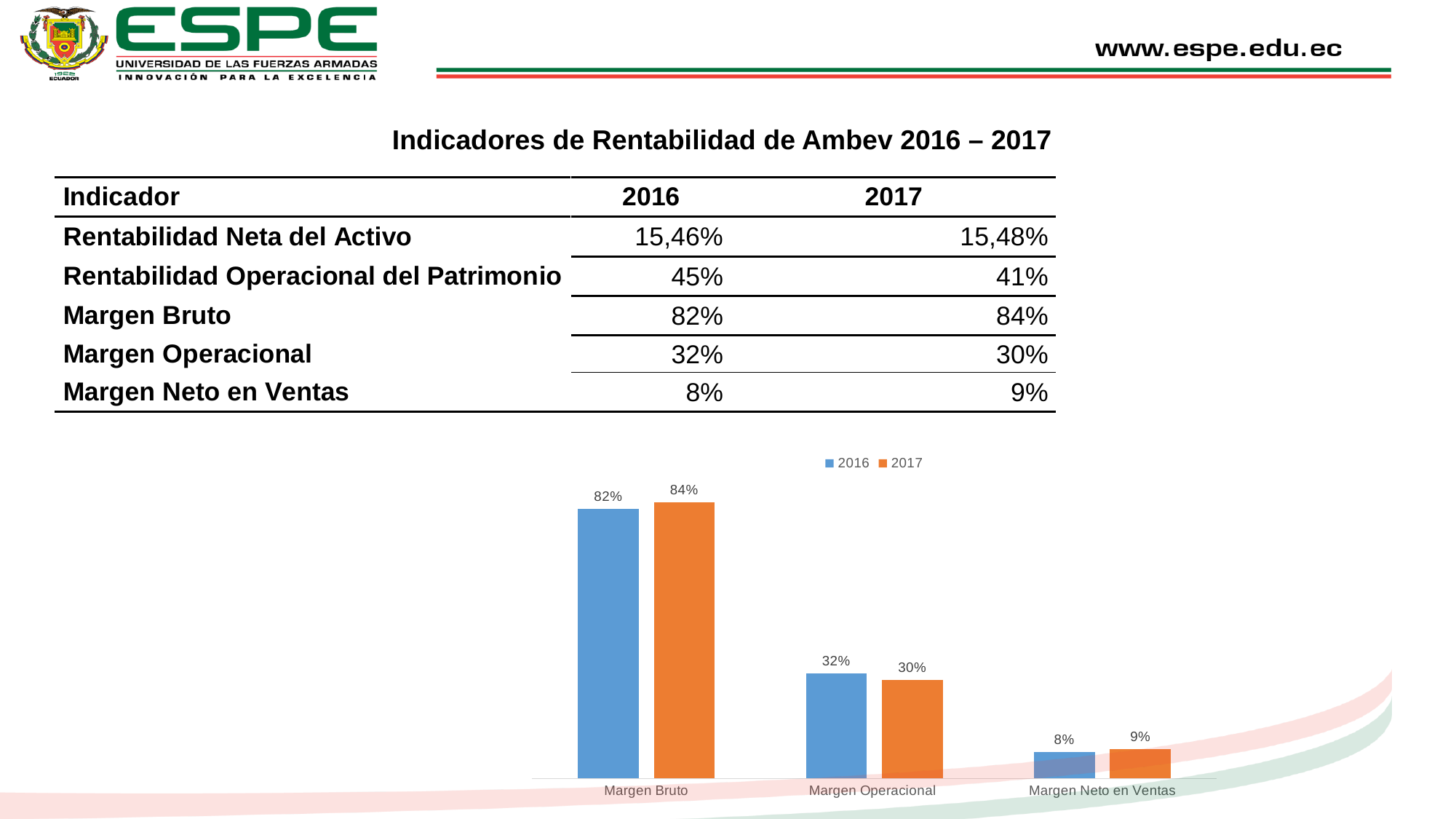
What is the 2017 value for Margen Operacional in the chart? 30% In the chart, is the 2016 or the 2017 value larger for Margen Operacional? 2016 What kind of chart is shown on the slide? Bar chart What is the 2016 value for Margen Bruto in the chart? 82% Which category has the lowest 2016 value in the chart? Margen Neto en Ventas What is the difference between the 2016 and 2017 values for Margen Operacional in the chart? 2% What is the 2017 value for Margen Neto en Ventas in the chart? 9% How many categories are shown on the x axis of the chart? 3 Which category has the highest 2017 value in the chart? Margen Bruto How many series does the chart legend list? 2 What is the difference between the 2017 and 2016 values for Margen Bruto in the chart? 2% Which colour represents the 2017 series in the chart? Orange